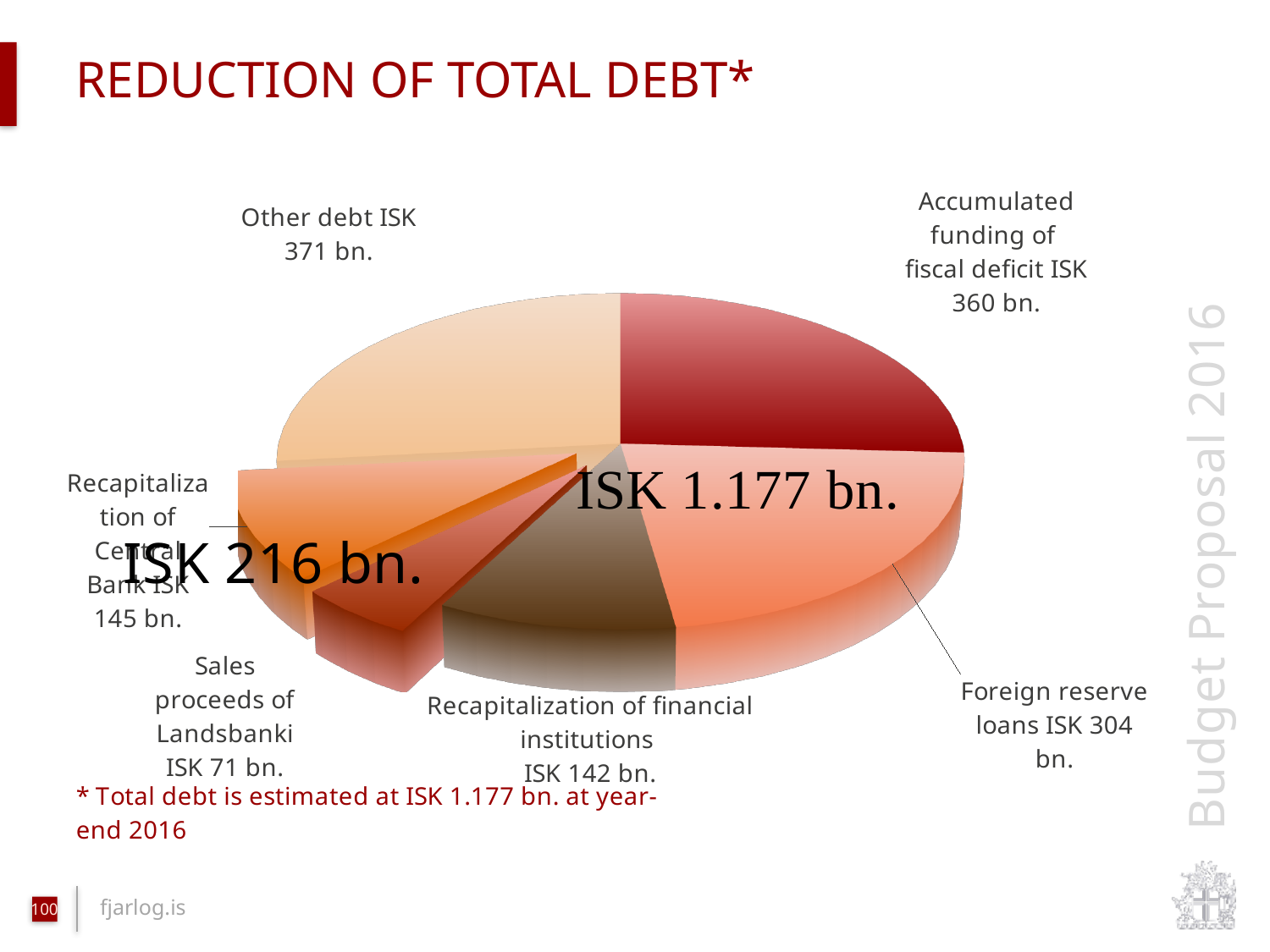
What is the value for Recapitalization of Central Bank? ISK 145 bn. What is the value for Other debt? ISK 371 bn. How many slices does the pie chart have? 6 Which category has the smallest value? Sales proceeds of Landsbanki What is the value for Sales proceeds of Landsbanki? ISK 71 bn. What is the difference between Other debt and Accumulated funding of fiscal deficit? ISK 11 bn. What is the value for Recapitalization of financial institutions? ISK 142 bn. What type of chart is shown on the slide? pie chart Which category has the largest value? Other debt Which is larger, Foreign reserve loans or Recapitalization of financial institutions? Foreign reserve loans What is the value for Accumulated funding of fiscal deficit? ISK 360 bn. What is the value for Foreign reserve loans? ISK 304 bn.